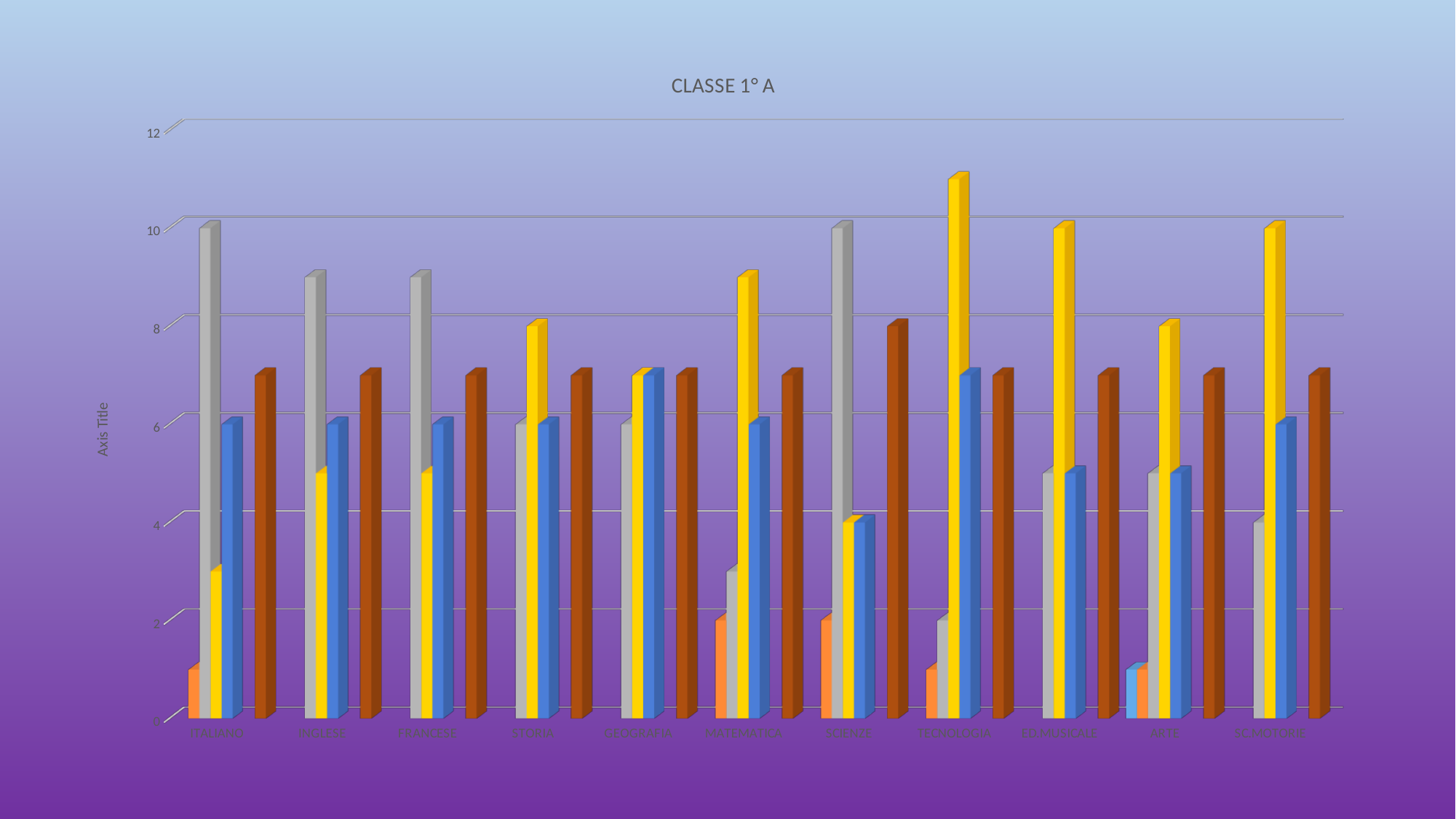
What value does the gray bar for ITALIANO reach on the axis? 10 Is the orange bar for ITALIANO greater or less than 2? less Is the yellow bar for TECNOLOGIA greater or less than 10? greater What kind of chart is shown on the slide? bar chart Is the brown bar for SCIENZE greater or less than 6? greater What is the title of the chart? CLASSE 1° A What value does the yellow bar for SC.MOTORIE reach on the axis? 10 Which is taller: the yellow bar for TECNOLOGIA or the yellow bar for MATEMATICA? TECNOLOGIA Which category has the tallest yellow bar? TECNOLOGIA How many subject categories are shown along the x axis? 11 What text is shown as the vertical axis title? Axis Title